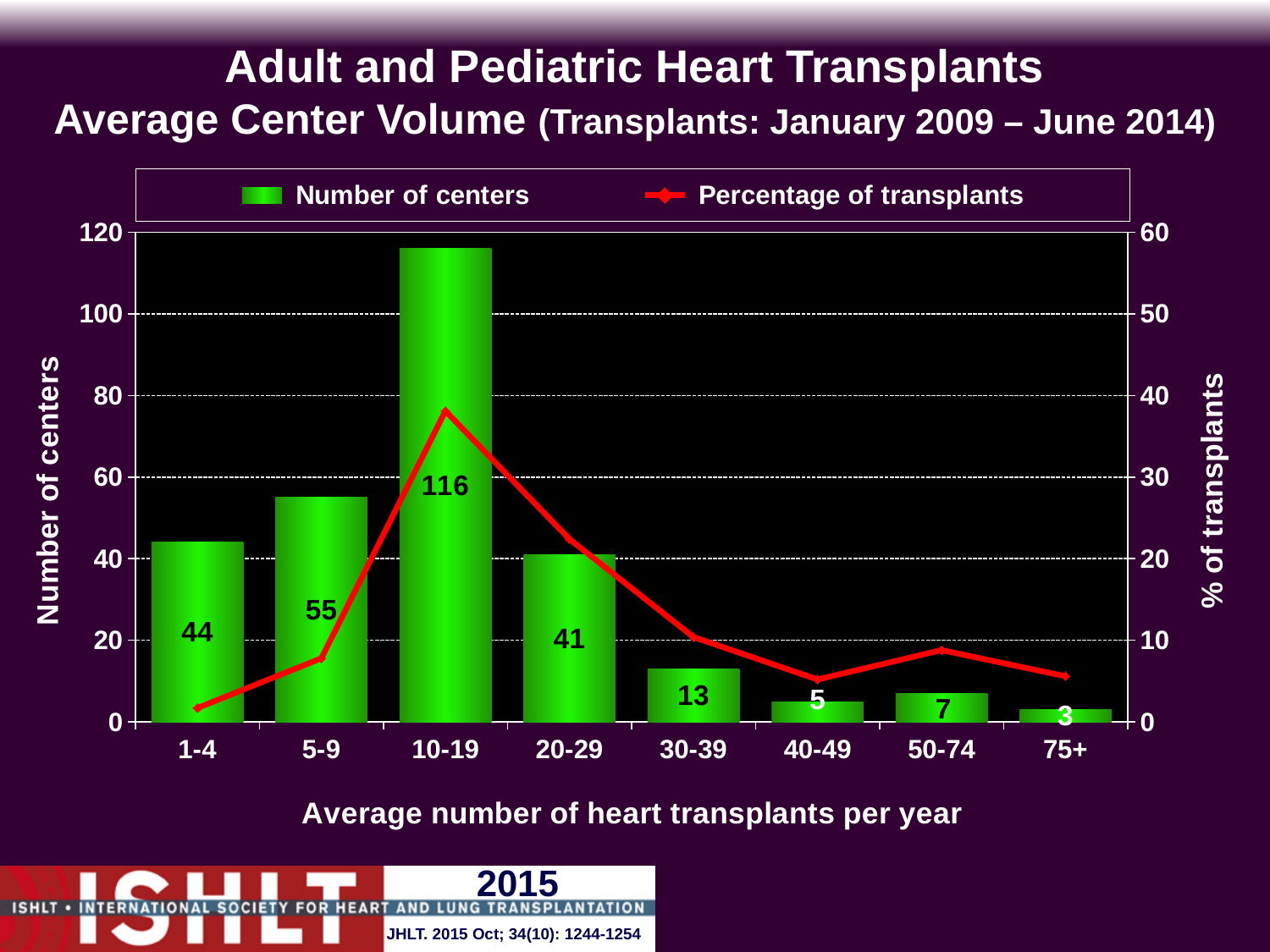
Which has more centers, the 20-29 category or the 40-49 category? 20-29 What is the label of the right-hand vertical axis? % of transplants Which category has the highest percentage of transplants? 10-19 Which category has the lowest number of centers? 75+ Which category has the highest number of centers? 10-19 How many centers are in the 10-19 category? 116 How many categories are shown on the x axis? 8 How many series does the legend list? 2 What is the difference in number of centers between the 5-9 and 1-4 categories? 11 Is the percentage of transplants for the 10-19 category greater or less than 30? greater Is the percentage of transplants for the 1-4 category greater or less than 10? less How many centers are in the 30-39 category? 13